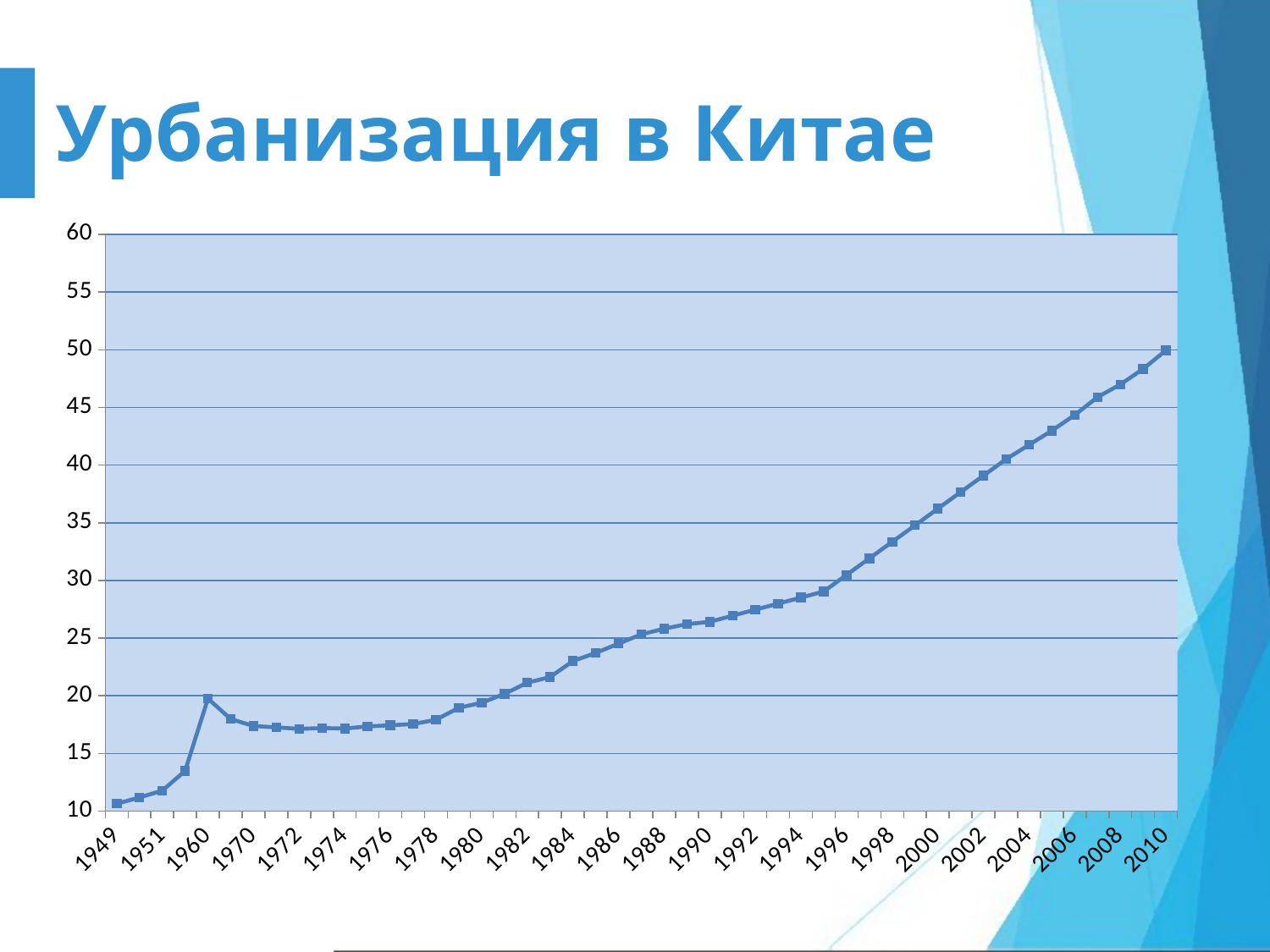
Is the value for 1972 greater or less than 20? less What is the title of the slide with the chart? Урбанизация в Китае Is the value for 2006 greater or less than 40? greater Is the value for 2000 greater or less than 35? greater Do the values generally rise or fall from 1978 to 2010? rise Which year has the lowest value on the chart? 1949 What kind of chart is shown on the slide? line chart Which year has the highest value on the chart? 2010 Which is larger, the value for 1960 or the value for 1970? 1960